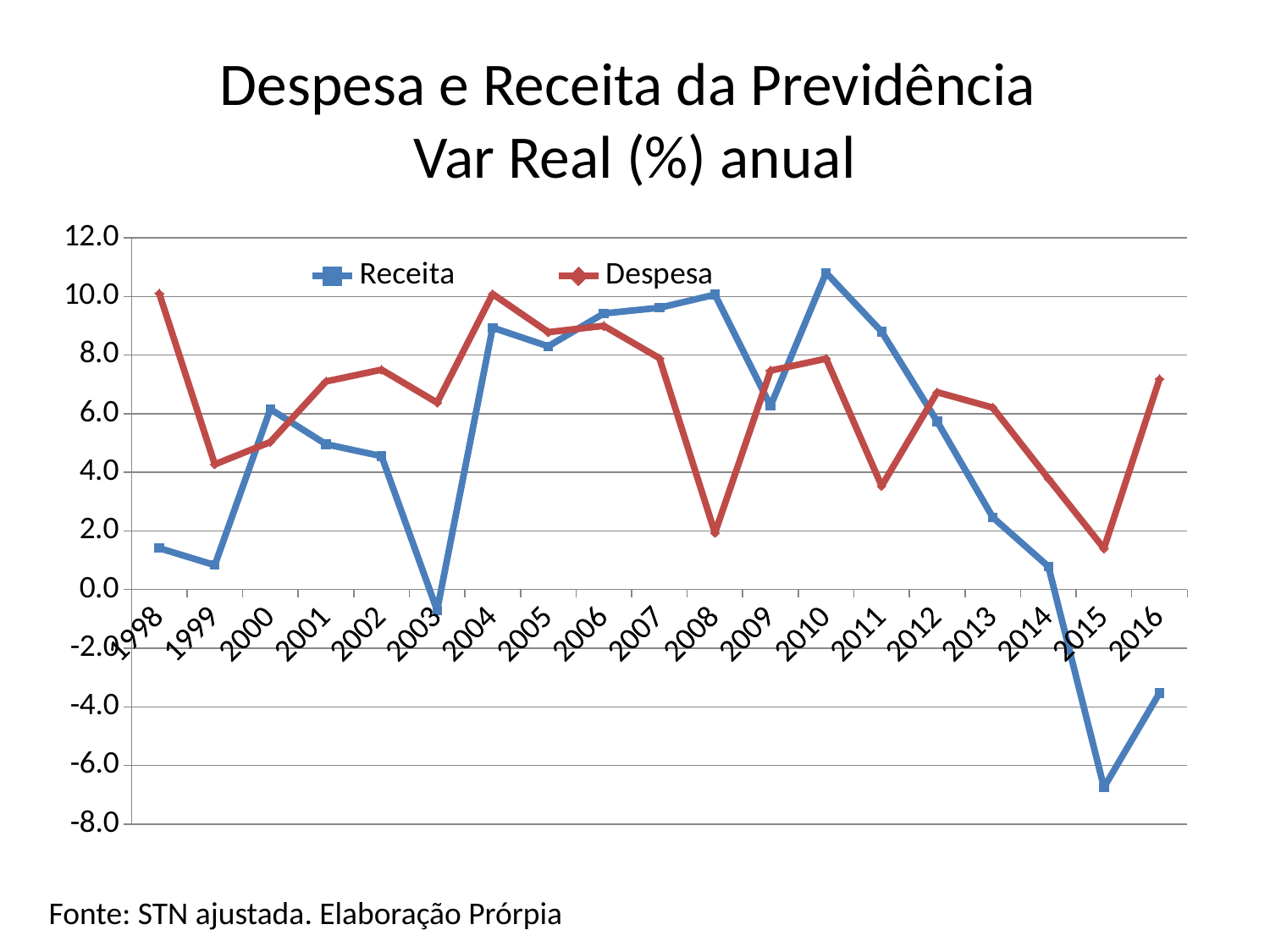
In which year does the Receita series reach its highest value? 2010 Is the Despesa value for 2016 greater or less than 6.0? greater Is the Receita value for 2010 greater or less than 10.0? greater Is the Receita value for 2015 greater or less than -6.0? less Which colour is used for the Despesa series? red How many series does the legend list? 2 Does the Receita series rise or fall from 2010 to 2015? fall What kind of chart is shown on the slide? line chart How many years are plotted along the x axis? 19 In 2015, which series has the larger value, Receita or Despesa? Despesa In which year does the Receita series reach its lowest value? 2015